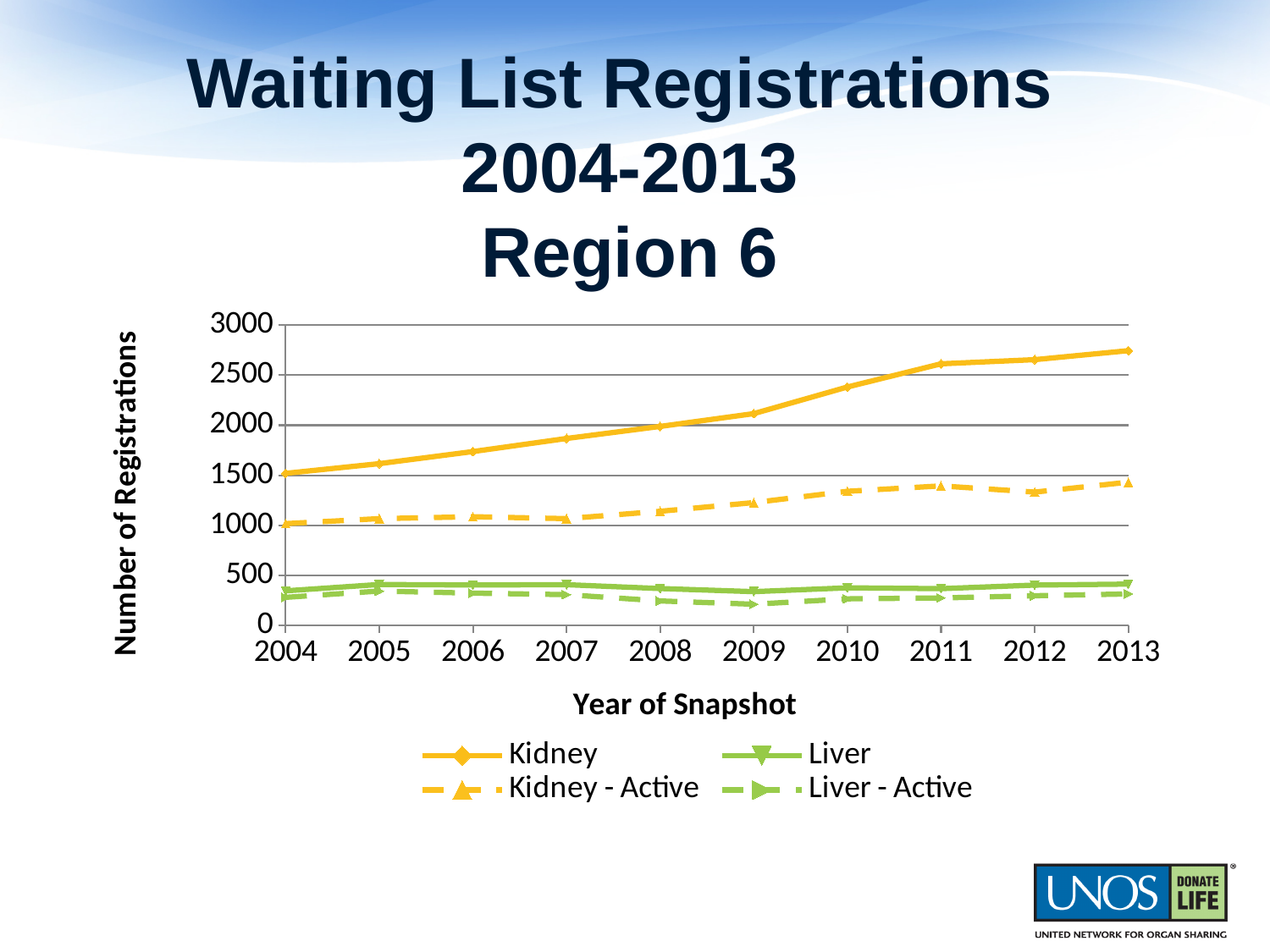
In which year is the Kidney series at its highest? 2013 Does the Kidney series rise or fall from 2004 to 2013? rise In which year is the Kidney series at its lowest? 2004 Is the value for Kidney - Active in 2004 greater or less than 1500? less In which year is the Liver - Active series at its lowest? 2009 How many years are plotted along the x axis? 10 Is the value for Liver in 2008 greater or less than 500? less What is the label on the y axis? Number of Registrations What kind of chart is shown on the slide? line chart Is the value for Kidney in 2013 greater or less than 2500? greater Which is larger in 2010, Kidney - Active or Liver - Active? Kidney - Active How many series does the legend list? 4